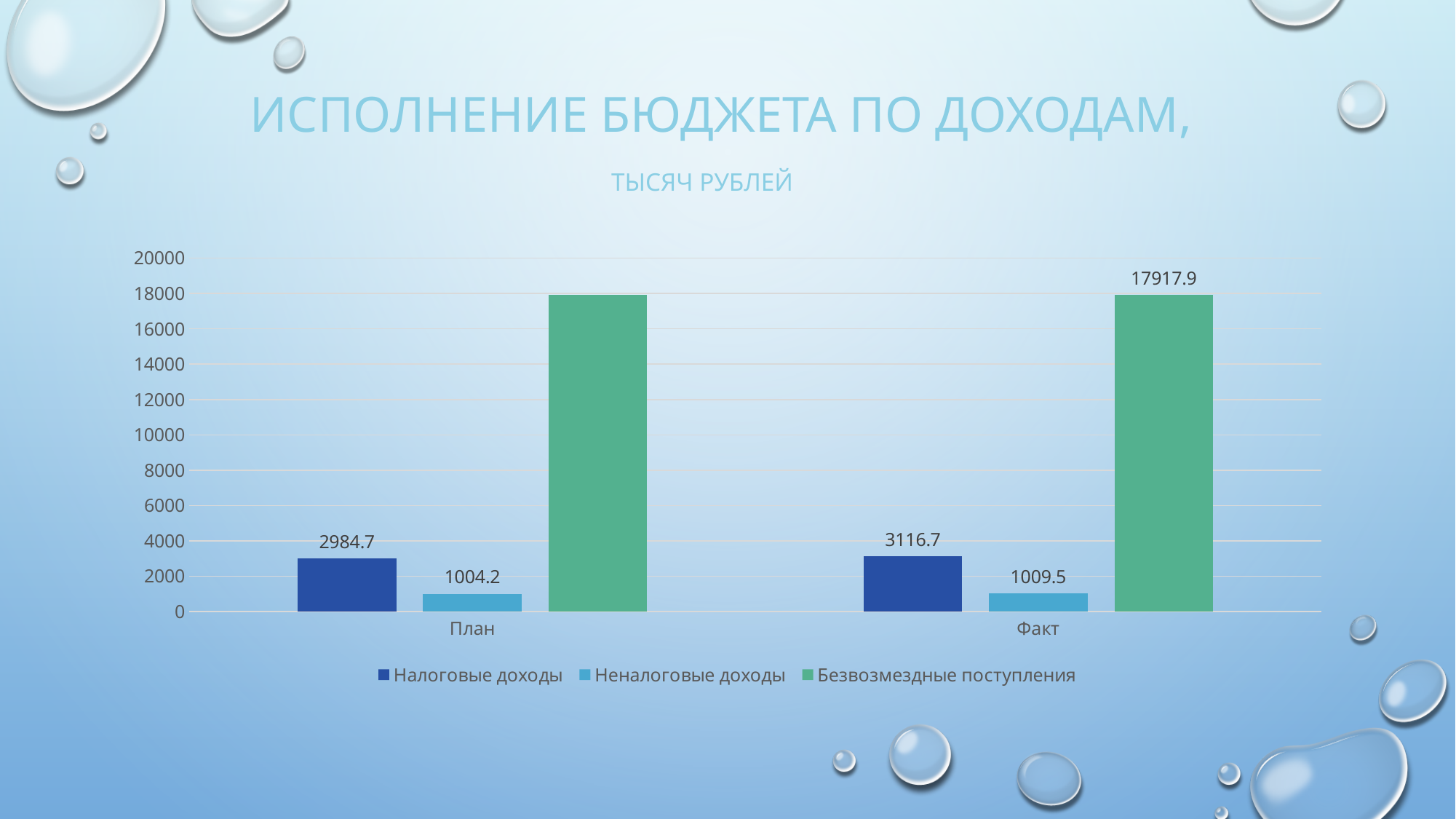
What is the value of Безвозмездные поступления for Факт? 17917.9 Which series has the lowest value in the План group? Неналоговые доходы What is the value of Неналоговые доходы for Факт? 1009.5 What type of chart is shown on the slide? bar chart Is the value of Безвозмездные поступления for План greater or less than 16000? greater What is the value of Налоговые доходы for План? 2984.7 What is the difference between Налоговые доходы for Факт and for План? 132.0 How many categories are shown on the x axis? 2 What is the value of Неналоговые доходы for План? 1004.2 Which series has the highest value in the Факт group? Безвозмездные поступления How many series does the legend list? 3 Which is larger: Неналоговые доходы for План or for Факт? Факт